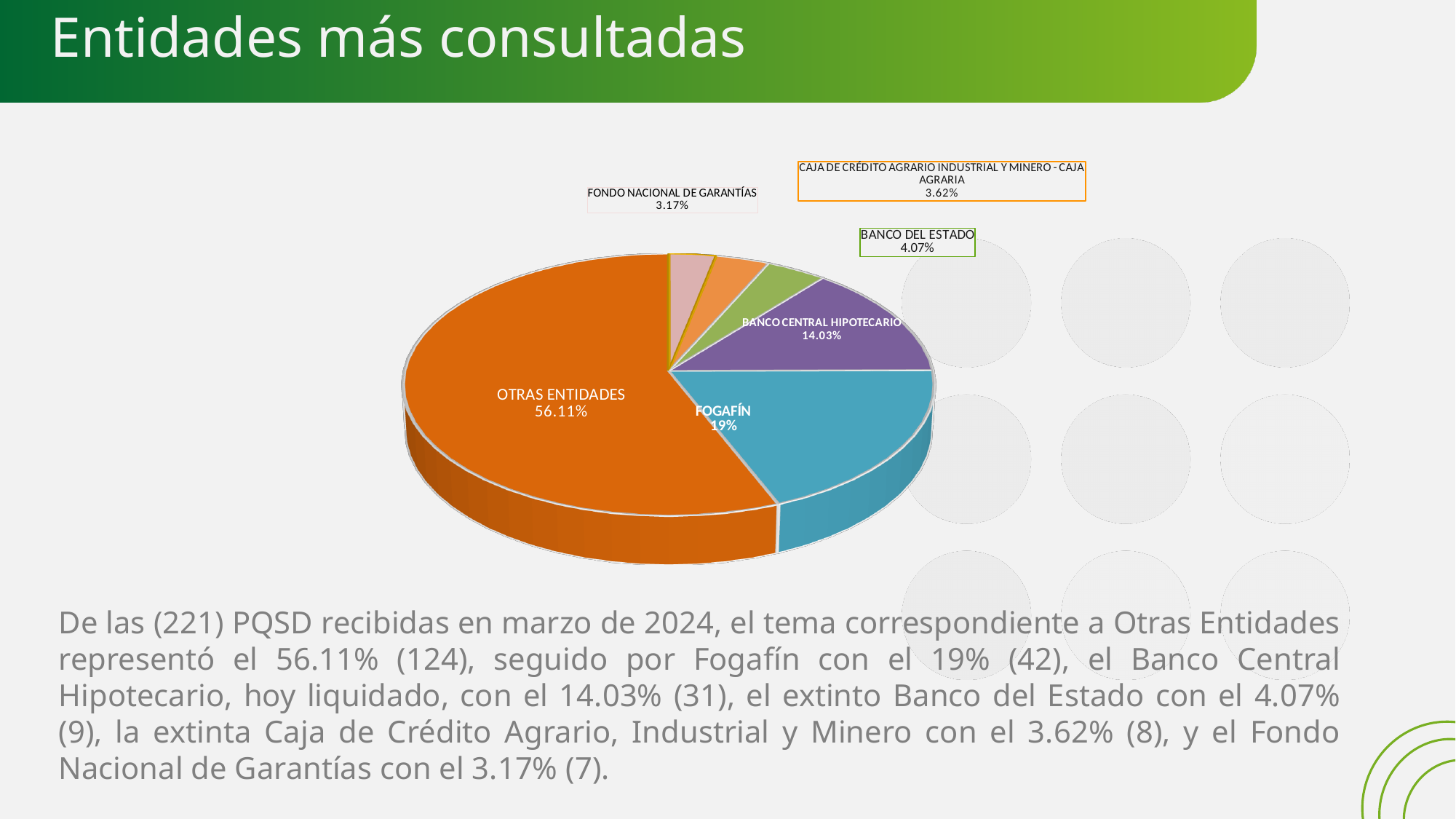
What colour is the OTRAS ENTIDADES slice? orange What is the difference between the shares of OTRAS ENTIDADES and FOGAFÍN? 37.11% Which is larger, the share for BANCO DEL ESTADO or the share for CAJA DE CRÉDITO AGRARIO INDUSTRIAL Y MINERO - CAJA AGRARIA? BANCO DEL ESTADO What kind of chart is shown on the slide? pie chart Which category has the largest slice of the pie? OTRAS ENTIDADES What is the value shown for BANCO DEL ESTADO? 4.07% What is the value shown for FONDO NACIONAL DE GARANTÍAS? 3.17% Which category has the smallest slice of the pie? FONDO NACIONAL DE GARANTÍAS How many slices does the pie chart have? 6 What is the value shown for FOGAFÍN? 19% What share of the pie does OTRAS ENTIDADES represent? 56.11% What is the value shown for BANCO CENTRAL HIPOTECARIO? 14.03%